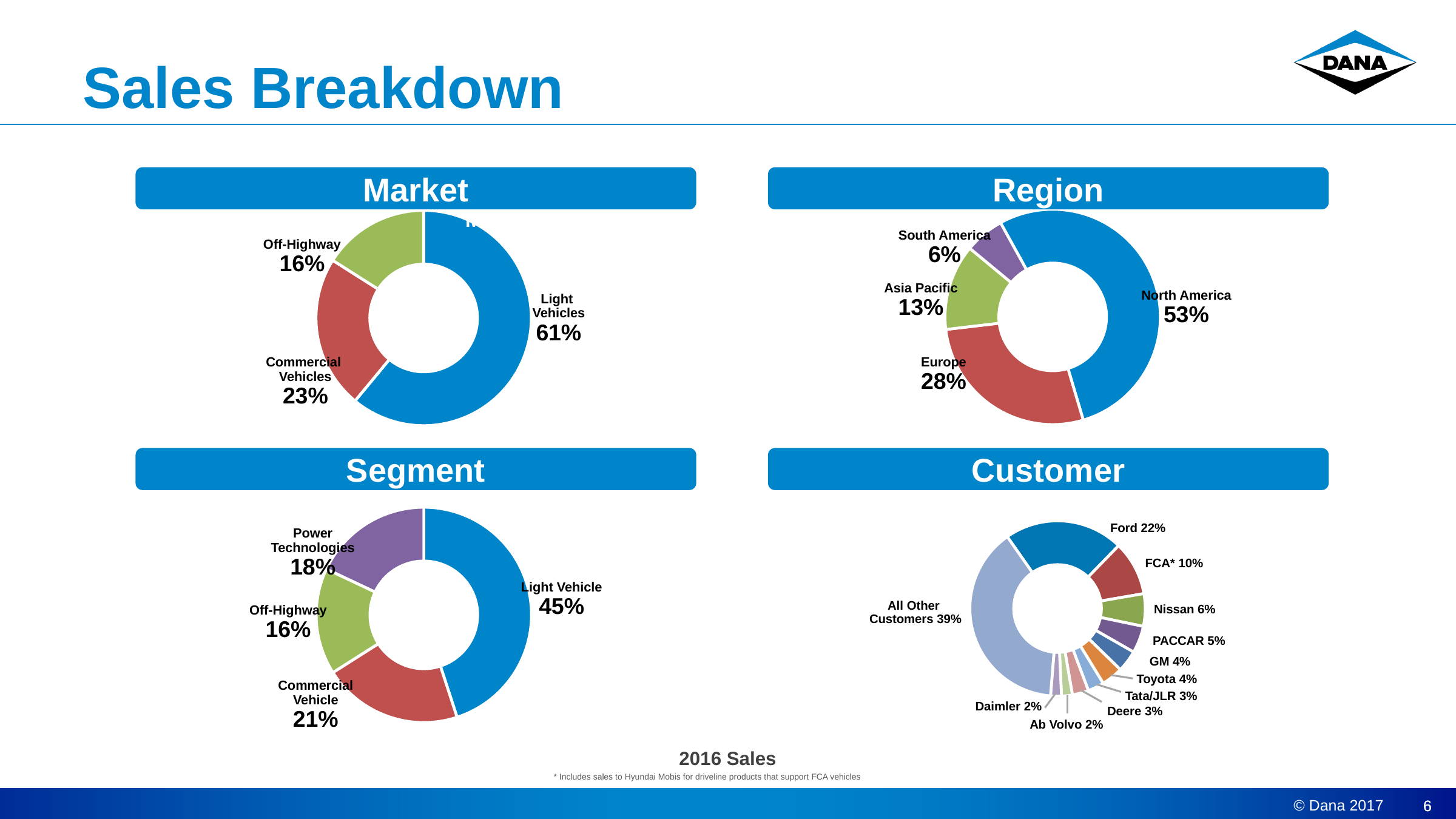
In the Segment chart, what share of sales comes from Power Technologies? 18% In the Region chart, what share of sales comes from Europe? 28% In the Region chart, what is the difference between the North America and Asia Pacific shares? 40% In the Segment chart, which is larger, Commercial Vehicle or Off-Highway? Commercial Vehicle In the Customer chart, what is the difference between the Ford and FCA* shares? 12% In the Market chart, which market has the smallest share of sales? Off-Highway In the Region chart, how many regions are shown? 4 In the Customer chart, what share of sales comes from Ford? 22% In the Customer chart, how many customer categories are shown? 11 In the Market chart, what share of sales comes from Light Vehicles? 61% In the Region chart, which region has the largest share of sales? North America What type of chart is the Segment chart? Donut (pie) chart